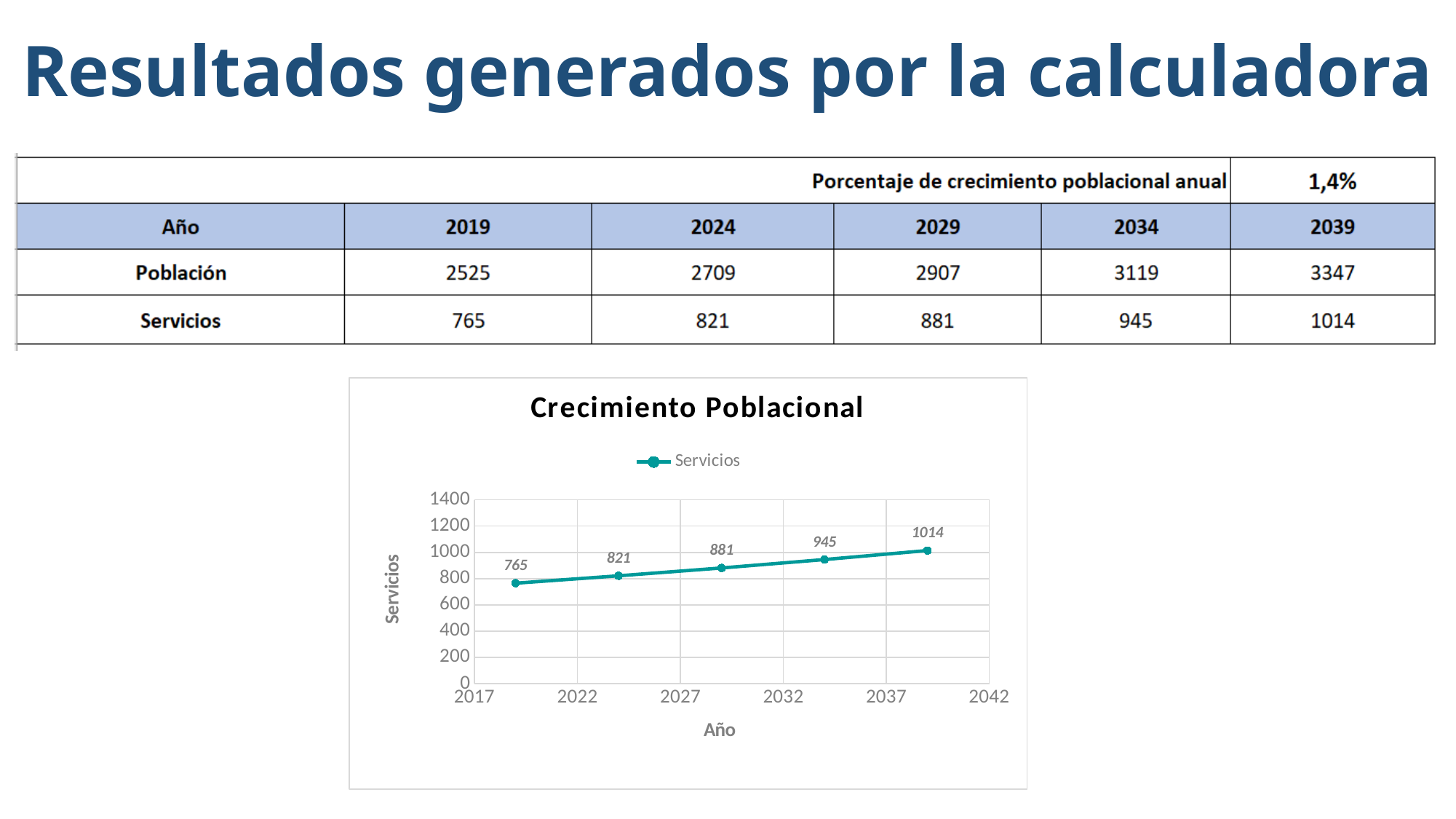
What is the value of the first data point on the Servicios line in the "Crecimiento Poblacional" chart? 765 What is the value of the last data point on the Servicios line in the "Crecimiento Poblacional" chart? 1014 Do the Servicios values rise or fall along the x axis in the "Crecimiento Poblacional" chart? rise What kind of chart is shown under the title "Crecimiento Poblacional"? line chart What is the label of the x axis in the "Crecimiento Poblacional" chart? Año What is the name of the series plotted in the "Crecimiento Poblacional" chart? Servicios How many series does the legend of the "Crecimiento Poblacional" chart list? 1 What is the value of the middle (third) data point on the Servicios line in the "Crecimiento Poblacional" chart? 881 Which data point on the Servicios line has the lowest value in the "Crecimiento Poblacional" chart? 765 How many data points are plotted on the Servicios line in the "Crecimiento Poblacional" chart? 5 Which data point on the Servicios line has the highest value in the "Crecimiento Poblacional" chart? 1014 In the "Crecimiento Poblacional" chart, what is the difference between the last data point (1014) and the first data point (765) on the Servicios line? 249